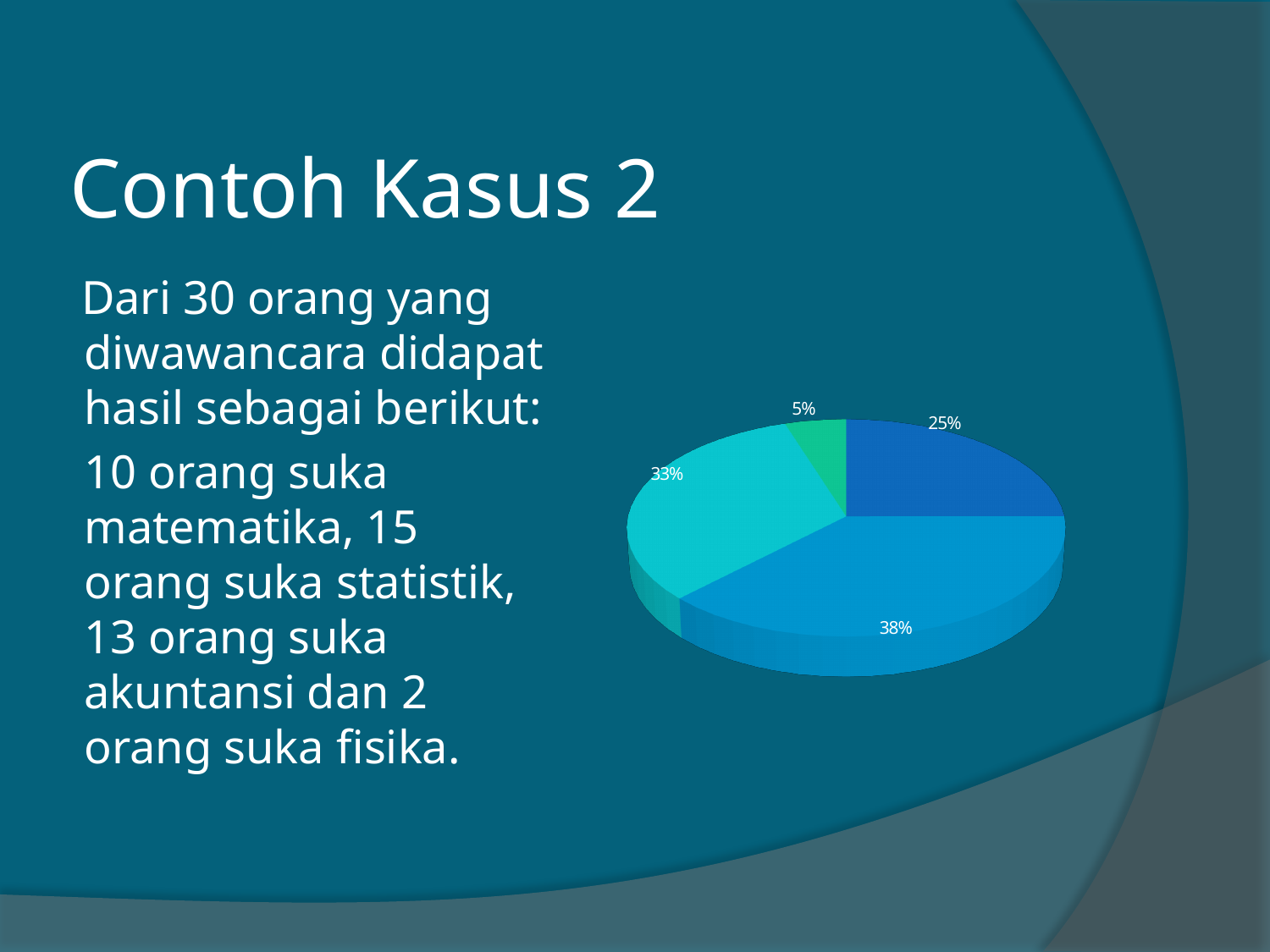
Does the pie chart on the slide have a legend? No What is the total of the 25% and 33% slices of the pie chart? 58% What is the difference between the largest slice (38%) and the smallest slice (5%) of the pie chart? 33% What is the largest percentage shown on the pie chart? 38% Which is larger on the pie chart, the dark blue slice or the light teal slice? the light teal slice (33%) What kind of chart is shown on the slide? pie chart What is the title of the slide containing the pie chart? Contoh Kasus 2 How many slices does the pie chart have? 4 What percentage is labelled on the green slice of the pie chart? 5% What percentage is labelled on the dark blue slice of the pie chart? 25% What is the smallest percentage shown on the pie chart? 5% What is the difference between the 38% slice and the 25% slice of the pie chart? 13%